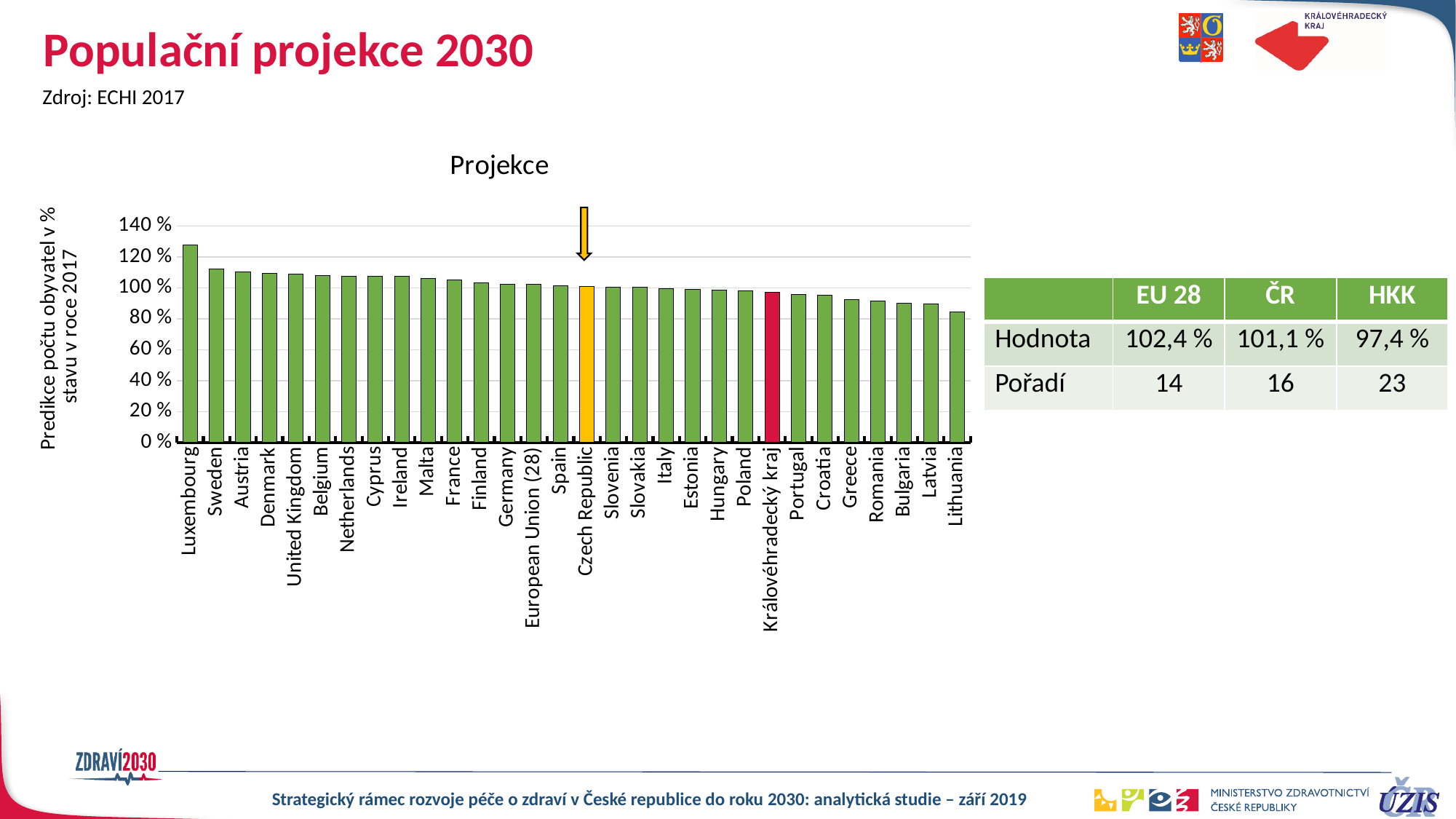
What is the value for the Czech Republic according to the table on the slide? 101,1 % Which category has the highest value in the chart? Luxembourg What is the difference between the EU 28 value and the Czech Republic value? 1,3 % What colour is the bar for Královéhradecký kraj? red Is the value for Lithuania greater or less than 100 %? less What is the value for EU 28 according to the table on the slide? 102,4 % How many bars (categories) are plotted in the chart? 30 What is the value for Královéhradecký kraj (HKK) according to the table on the slide? 97,4 % Do the values rise or fall from left to right along the x axis? fall Which category has the lowest value in the chart? Lithuania Is the value for Luxembourg greater or less than 120 %? greater What kind of chart is shown on the slide? bar chart